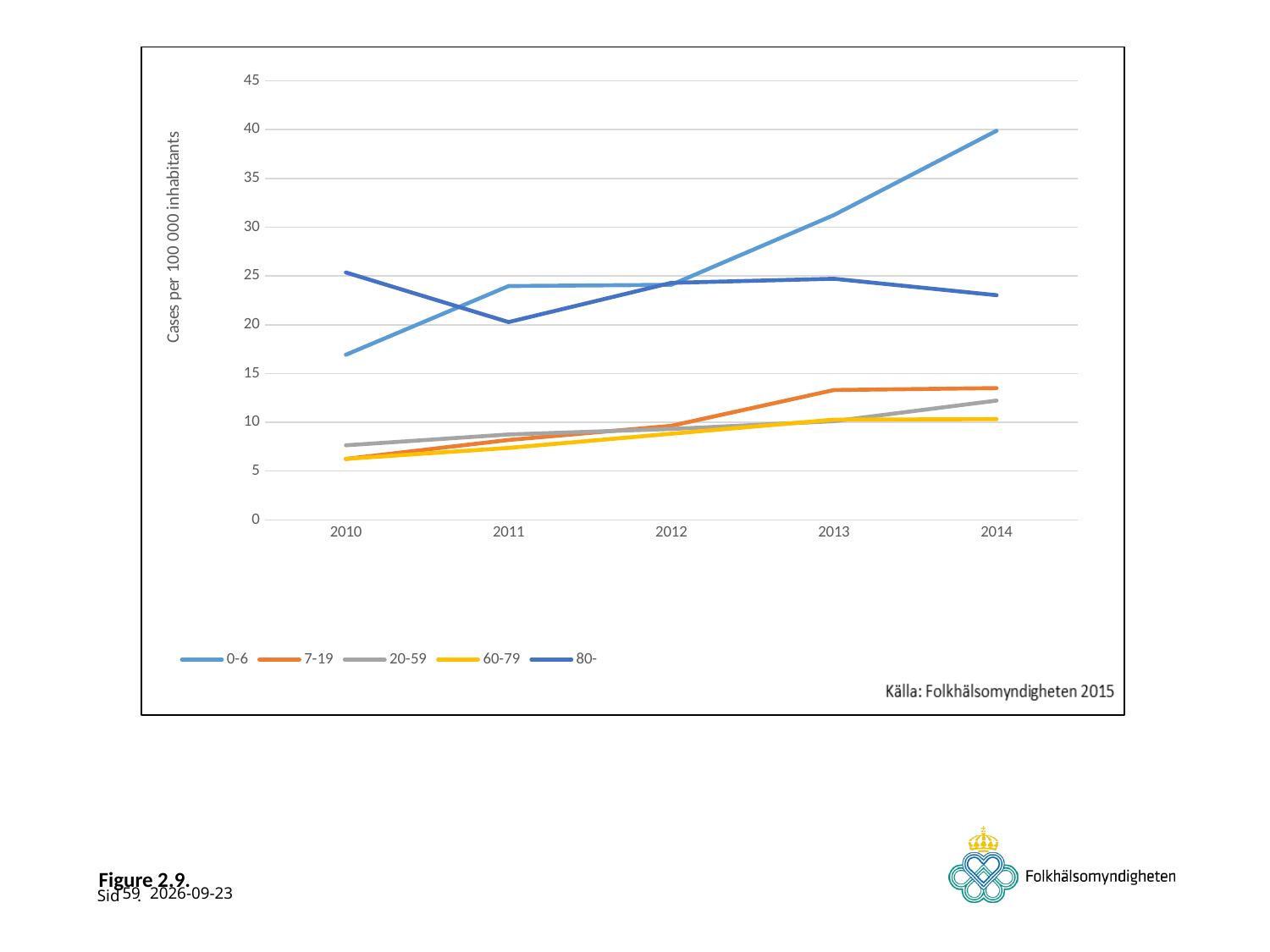
Which age group has the lowest value in 2014? 60-79 Which age group has the highest value in 2014? 0-6 How many series does the legend list? 5 Does the value for the 0-6 age group rise or fall from 2010 to 2014? rise How many years are shown on the x axis? 5 Is the value for the 0-6 age group in 2014 greater or less than 35? greater Is the value for the 80- age group in 2011 greater or less than 25? less Which age group has the highest value in 2010? 80- Is the value for the 7-19 age group in 2013 greater or less than 10? greater In 2010, which is larger: the value for the 0-6 age group or the 80- age group? 80- What is the label of the y axis? Cases per 100 000 inhabitants What kind of chart is shown on the slide? line chart